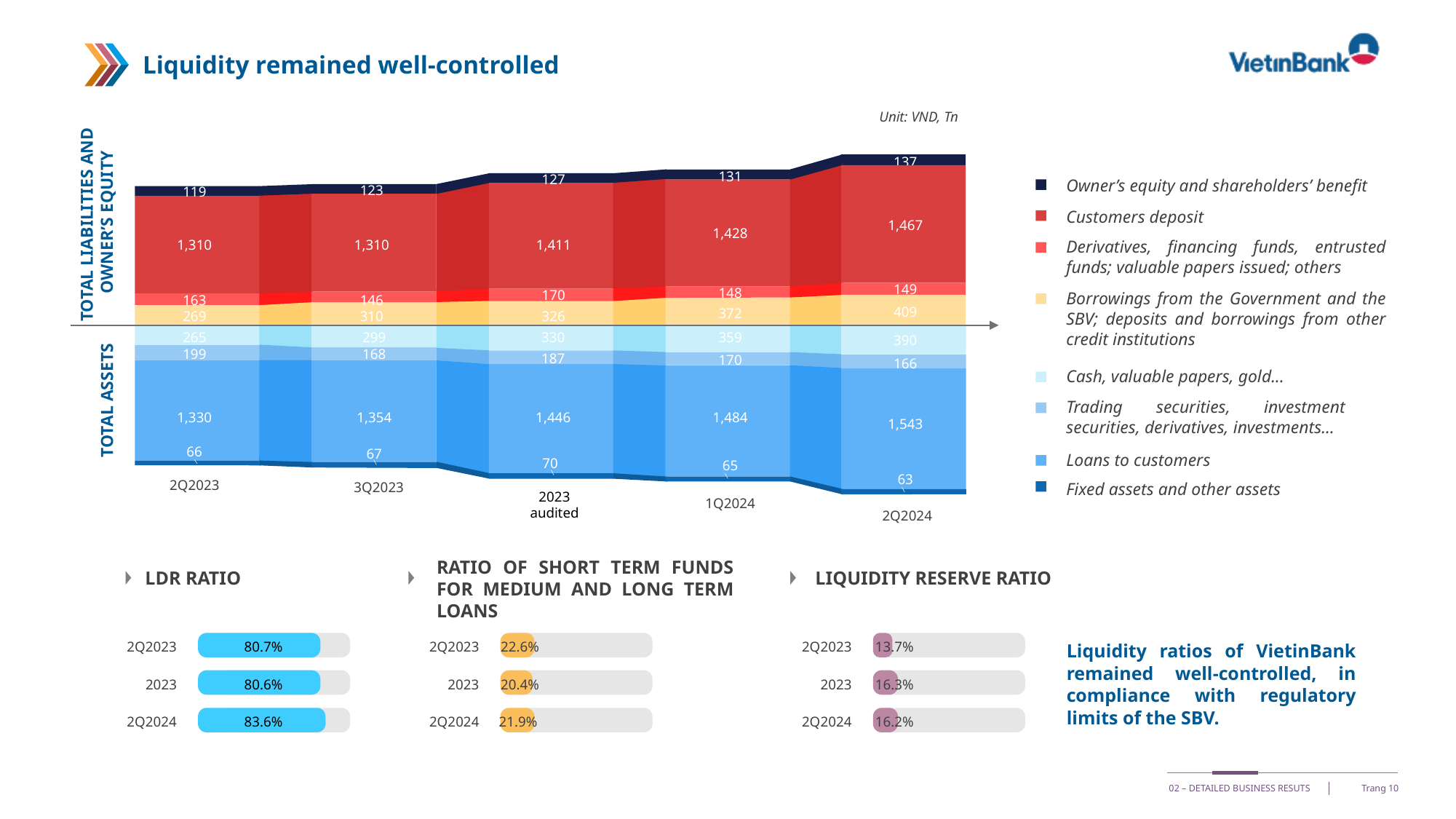
In the total liabilities and total assets chart, what is the value for Customers deposit in 2Q2024? 1,467 In the ratio of short term funds for medium and long term loans chart, which is larger: 2Q2023 or 2Q2024? 2Q2023 What unit is stated for the total liabilities and total assets chart? VND, Tn In the total liabilities and total assets chart, in which period is Owner's equity and shareholders' benefit highest? 2Q2024 In the total liabilities and total assets chart, what is the value for Loans to customers in 2023 audited? 1,446 In the total liabilities and total assets chart, do the values for Borrowings from the Government and the SBV; deposits and borrowings from other credit institutions rise or fall from 2Q2023 to 2Q2024? rise How many series does the legend of the total liabilities and total assets chart list? 8 In the liquidity reserve ratio chart, which period has the lowest value? 2Q2023 In the total liabilities and total assets chart, which is larger: Fixed assets and other assets in 2023 audited or in 2Q2024? 2023 audited How many periods are shown on the x axis of the total liabilities and total assets chart? 5 In the LDR ratio chart, what is the value for 2Q2024? 83.6% In the total liabilities and total assets chart, what is the difference between Loans to customers in 2Q2024 and in 2Q2023? 213